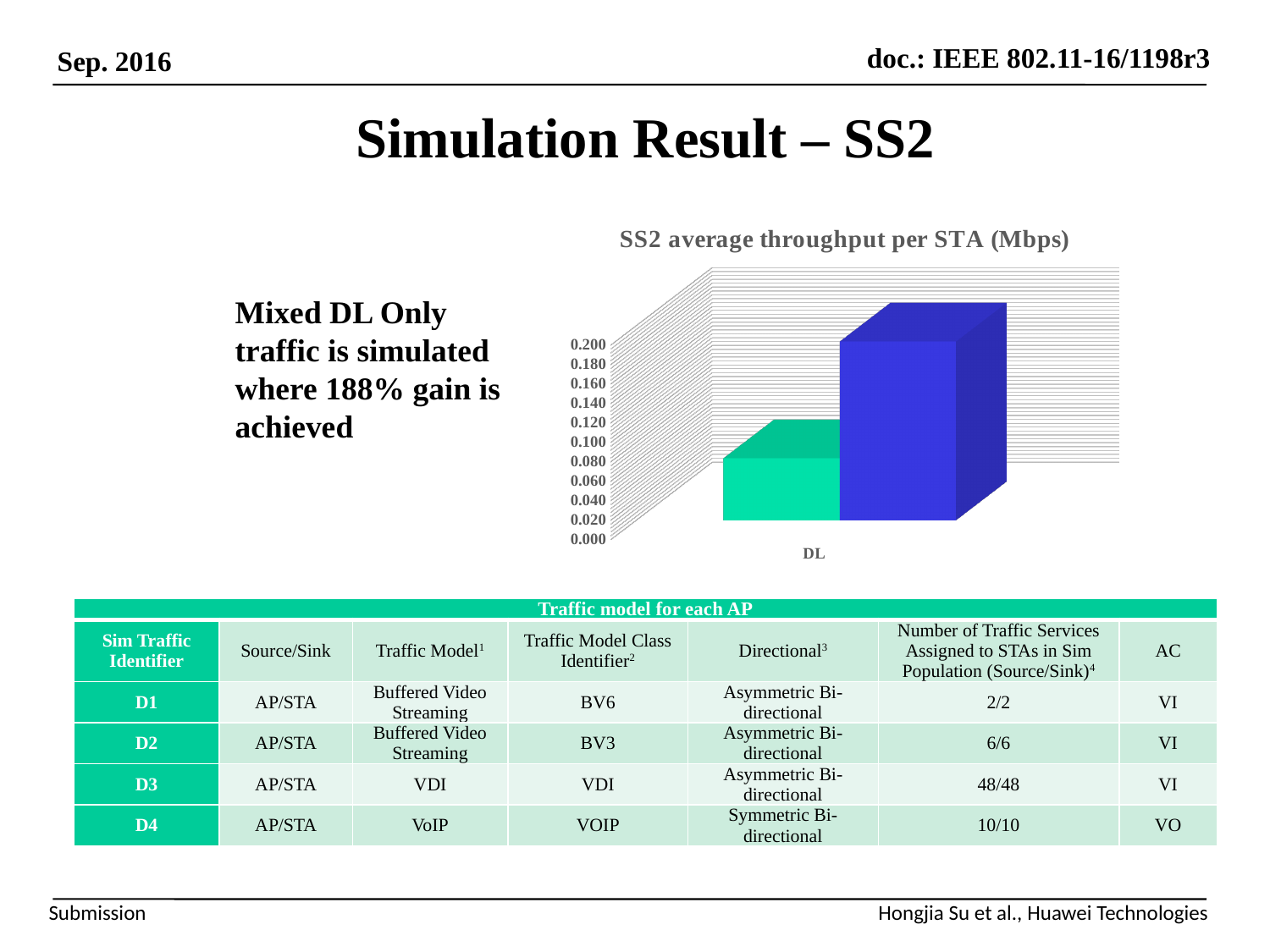
Is the value of the green bar for DL greater or less than 0.100? less What is the label of the category on the x axis of the chart? DL Which bar is taller in the chart, the green bar or the blue bar? the blue bar Which bar in the chart has the lowest value? the green bar How many categories are shown on the x axis of the chart? 1 Is the value of the green bar for DL greater or less than 0.120? less What is the title of the chart? SS2 average throughput per STA (Mbps) Which bar in the chart has the highest value? the blue bar What kind of chart is shown on the slide? bar chart Is the value of the blue bar for DL greater or less than 0.140? greater